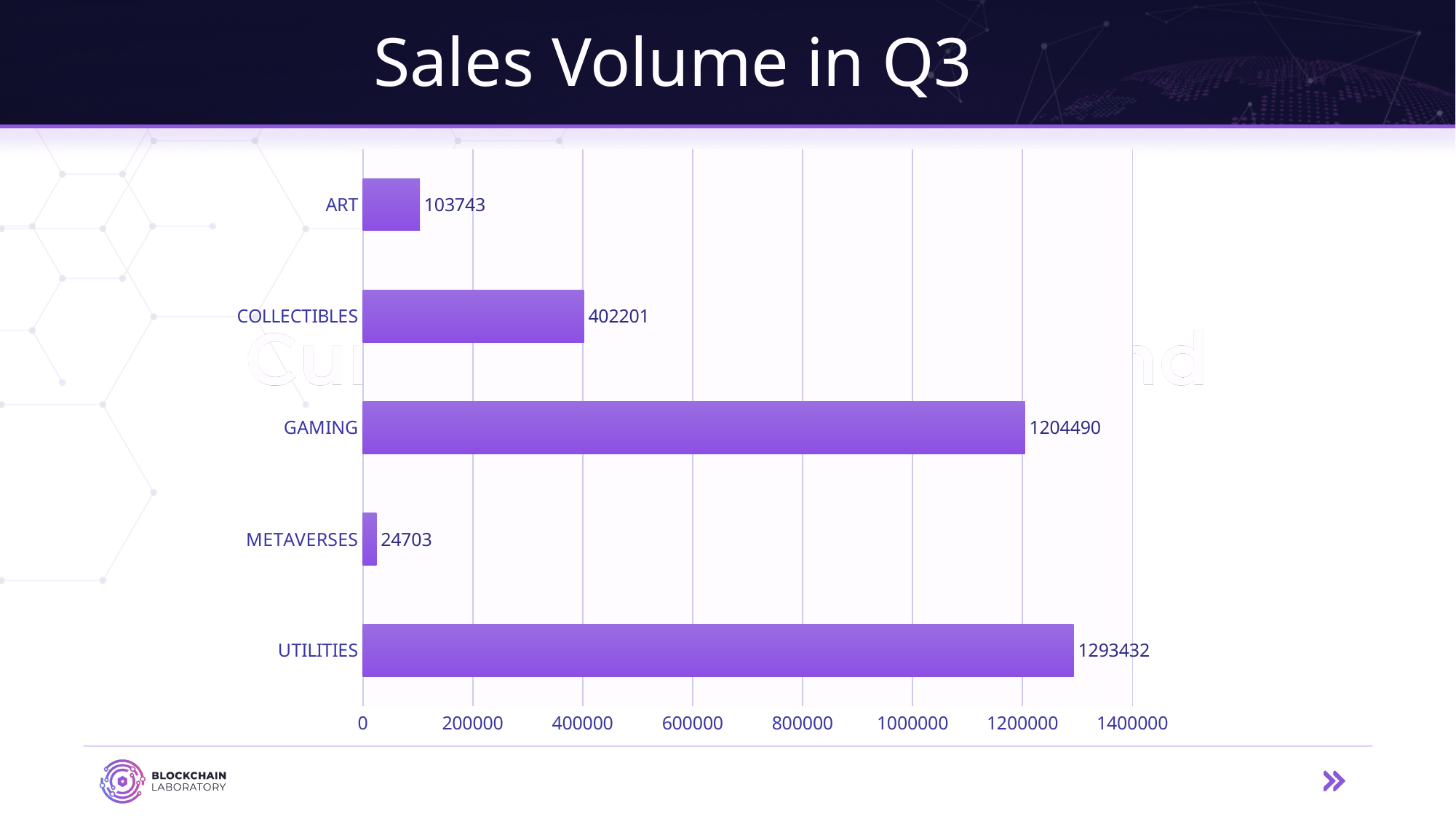
What is the sales volume for ART? 103743 What is the sales volume for GAMING? 1204490 What is the difference in sales volume between COLLECTIBLES and ART? 298458 What is the difference in sales volume between UTILITIES and GAMING? 88942 What is the sales volume for METAVERSES? 24703 What type of chart is shown on the slide? Bar chart What is the sales volume for COLLECTIBLES? 402201 Which category has the highest sales volume? UTILITIES How many categories are shown in the chart? 5 Which has a larger sales volume, COLLECTIBLES or ART? COLLECTIBLES Which category has the lowest sales volume? METAVERSES Is the value for GAMING greater or less than 1000000? greater